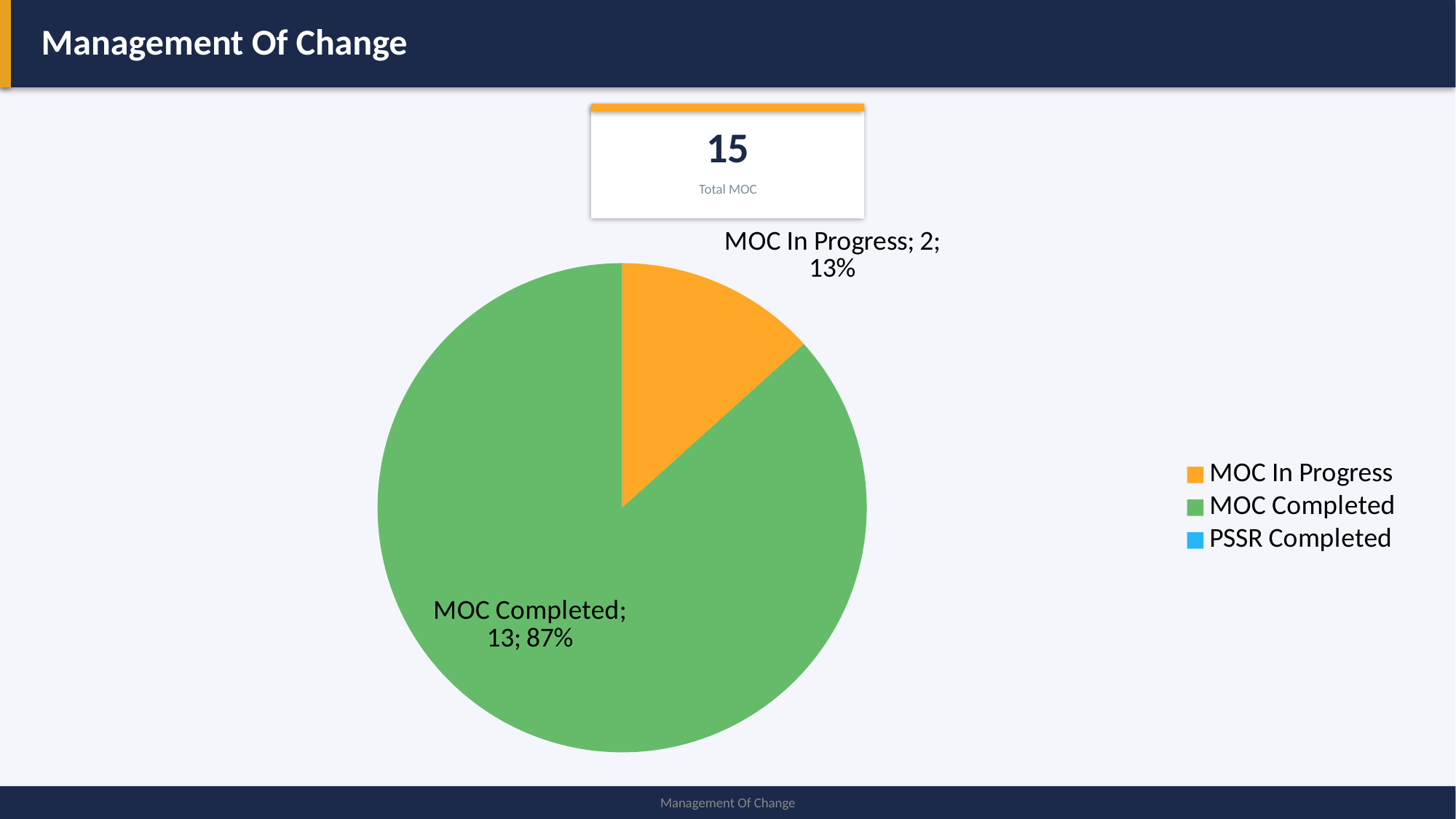
What is the difference between the MOC Completed count and the MOC In Progress count? 11 What share of the pie does MOC In Progress represent? 13% How many entries does the legend list? 3 What is the Total MOC value shown in the box above the pie chart? 15 What colour is the MOC Completed slice? green Which category has the largest slice of the pie? MOC Completed Which legend entry has no visible slice in the pie? PSSR Completed How many MOC In Progress are shown in the pie chart? 2 Which of the two labelled slices is larger, MOC In Progress or MOC Completed? MOC Completed What share of the pie does MOC Completed represent? 87% What kind of chart is shown on the slide? pie chart How many MOC Completed are shown in the pie chart? 13